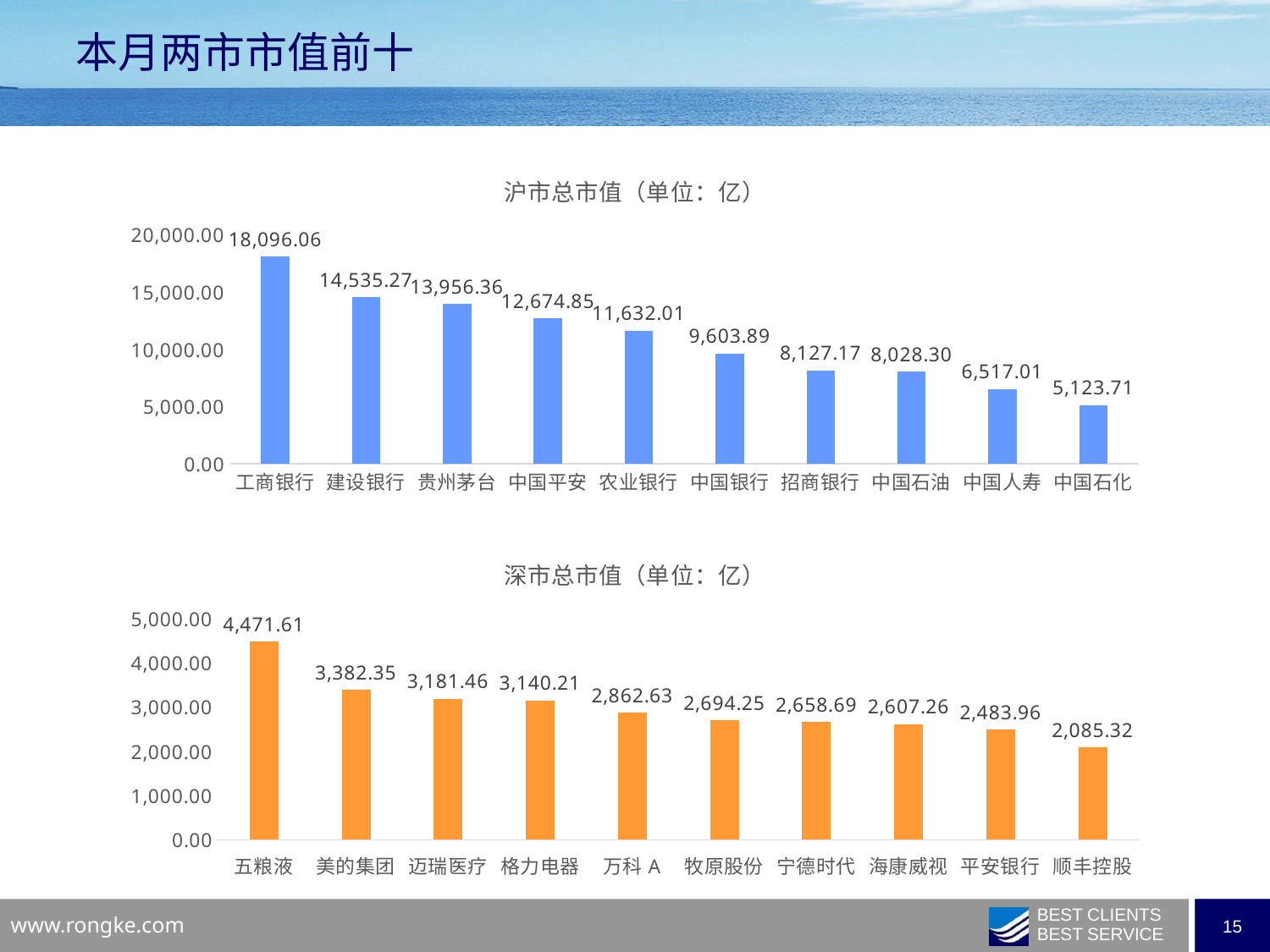
In the 深市总市值（单位：亿） chart, which category has the highest value? 五粮液 In the 沪市总市值（单位：亿） chart, what is the difference between 工商银行 and 建设银行? 3,560.79 In the 沪市总市值（单位：亿） chart, how many categories are shown? 10 In the 深市总市值（单位：亿） chart, which is larger, 美的集团 or 格力电器? 美的集团 In the 深市总市值（单位：亿） chart, what is the difference between 五粮液 and 顺丰控股? 2,386.29 What colour are the bars in the 深市总市值（单位：亿） chart? orange In the 沪市总市值（单位：亿） chart, what is the value for 中国平安? 12,674.85 In the 深市总市值（单位：亿） chart, what is the value for 宁德时代? 2,658.69 In the 沪市总市值（单位：亿） chart, what is the value for 工商银行? 18,096.06 In the 沪市总市值（单位：亿） chart, which category has the lowest value? 中国石化 In the 沪市总市值（单位：亿） chart, do the values rise or fall from left to right? fall What type of chart is the 深市总市值（单位：亿） chart? bar chart